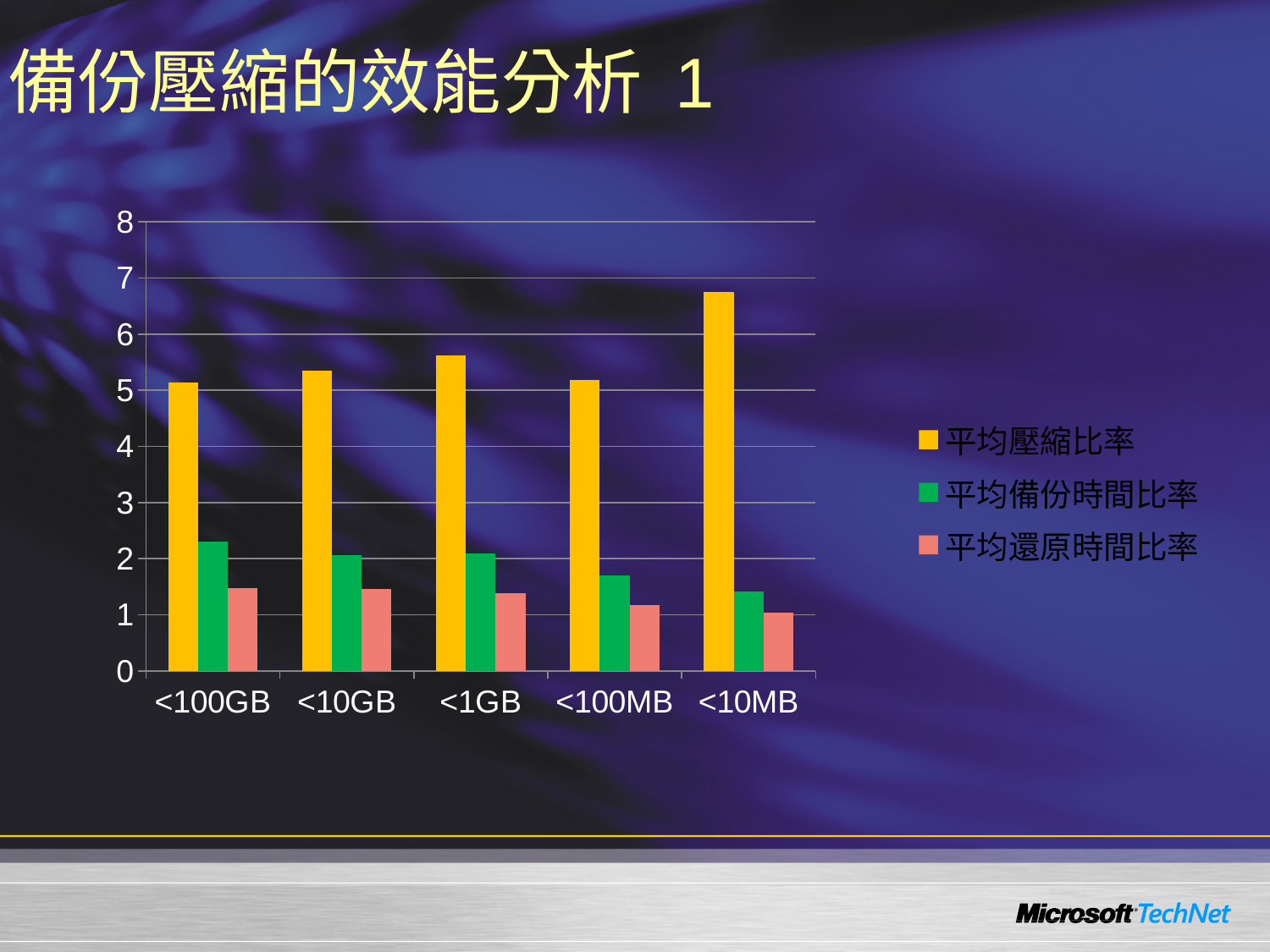
Which colour represents 平均備份時間比率 in the legend? green Is the value of 平均還原時間比率 for <10MB greater or less than 2? less Is the value of 平均壓縮比率 for <100GB greater or less than 6? less Is the value of 平均壓縮比率 for <10MB greater or less than 6? greater How many series does the legend list? 3 How many categories are shown on the x axis? 5 Which category has the highest value for 平均壓縮比率? <10MB Which is larger: 平均壓縮比率 for <1GB or 平均壓縮比率 for <10GB? <1GB What kind of chart is shown on the slide? bar chart Do the values of 平均還原時間比率 rise or fall from <100GB to <10MB along the x axis? fall Which category has the lowest value for 平均備份時間比率? <10MB